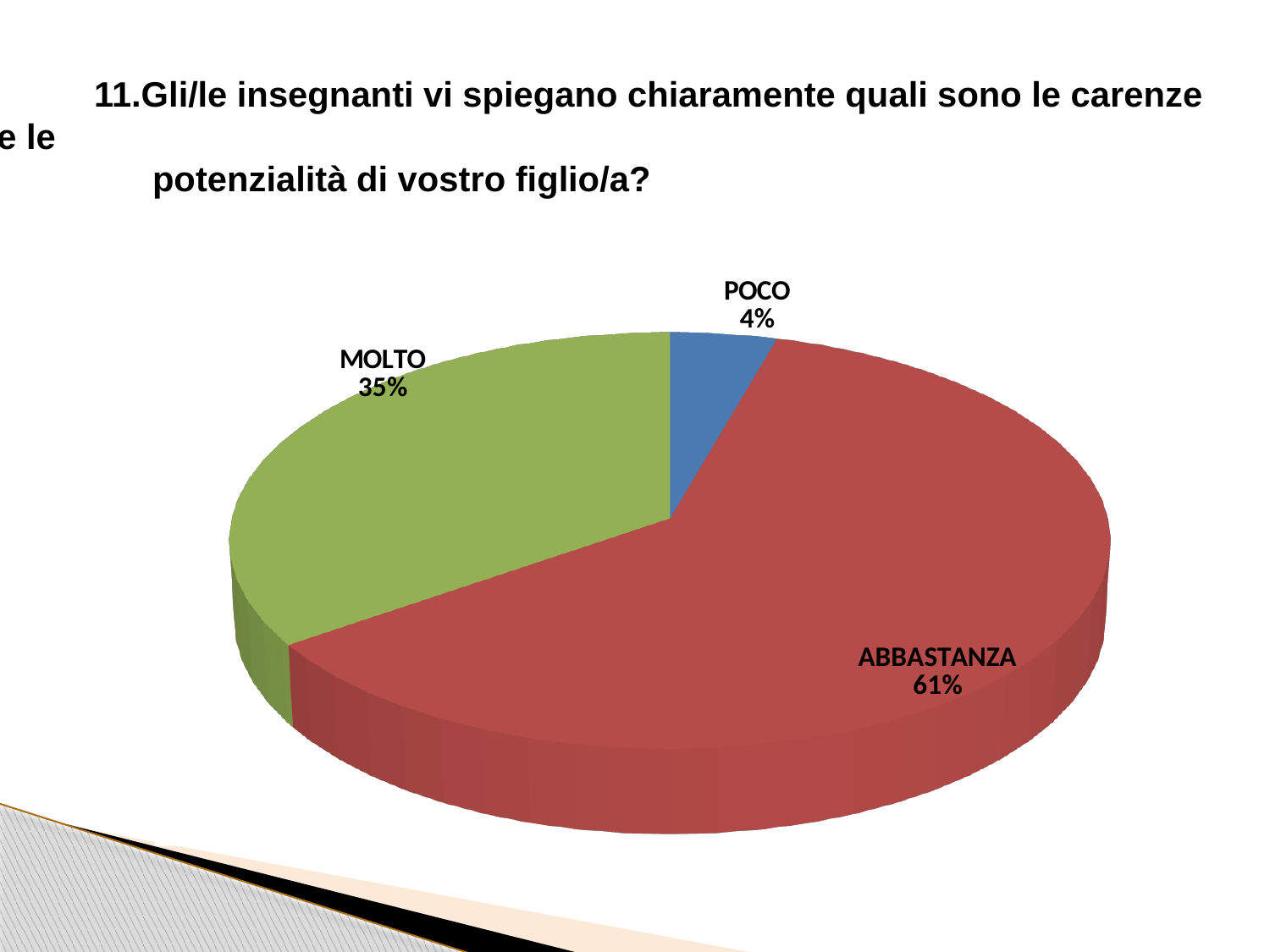
What colour is the MOLTO slice? green What percentage of the pie is labelled ABBASTANZA? 61% What kind of chart is shown on the slide? pie chart Which category has the largest share of the pie? ABBASTANZA What is the difference in percentage points between ABBASTANZA and MOLTO? 26 What percentage of the pie is labelled POCO? 4% What percentage of the pie is labelled MOLTO? 35% What is the difference in percentage points between MOLTO and POCO? 31 Which category has the smallest share of the pie? POCO How many slices does the pie chart have? 3 Which is larger, the share for MOLTO or the share for POCO? MOLTO What colour is the ABBASTANZA slice? red